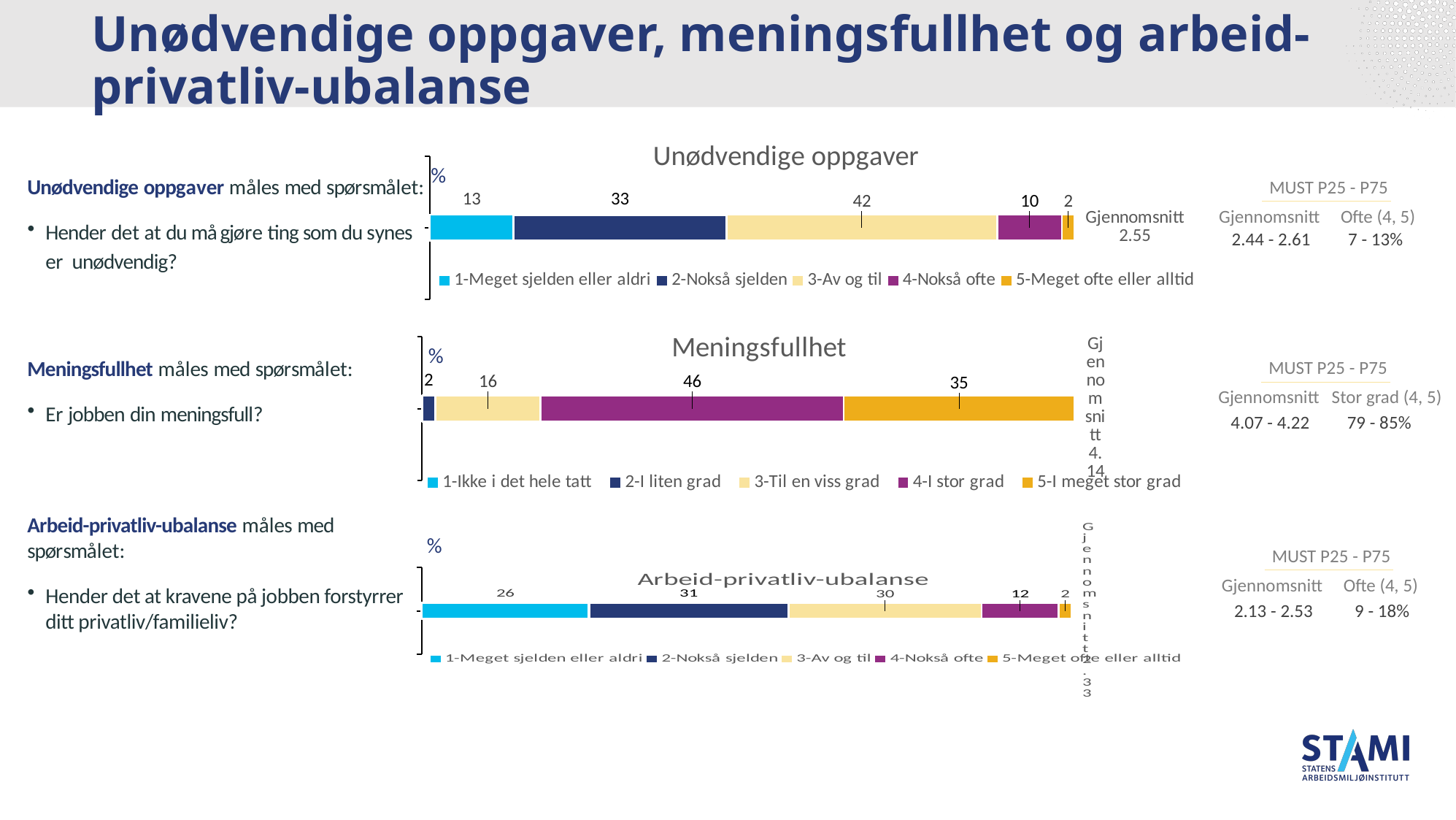
In the 'Meningsfullhet' chart, what is the value for '4-I stor grad'? 46 In the 'Arbeid-privatliv-ubalanse' chart, what is the value for '2-Nokså sjelden'? 31 In the 'Arbeid-privatliv-ubalanse' chart, what is the difference between '1-Meget sjelden eller aldri' and '4-Nokså ofte'? 14 In the 'Unødvendige oppgaver' chart, what is the value for '3-Av og til'? 42 In the 'Meningsfullhet' chart, what is the value for '2-I liten grad'? 2 How many series does the legend of the 'Unødvendige oppgaver' chart list? 5 In the 'Meningsfullhet' chart, which is larger, '5-I meget stor grad' or '3-Til en viss grad'? 5-I meget stor grad In the 'Unødvendige oppgaver' chart, which category has the lowest value? 5-Meget ofte eller alltid In the 'Unødvendige oppgaver' chart, which category has the highest value? 3-Av og til What kind of chart is the 'Arbeid-privatliv-ubalanse' chart? Stacked bar chart In the 'Unødvendige oppgaver' chart, what is the difference between '2-Nokså sjelden' and '1-Meget sjelden eller aldri'? 20 What is the Gjennomsnitt (average) shown next to the 'Unødvendige oppgaver' chart? 2.55